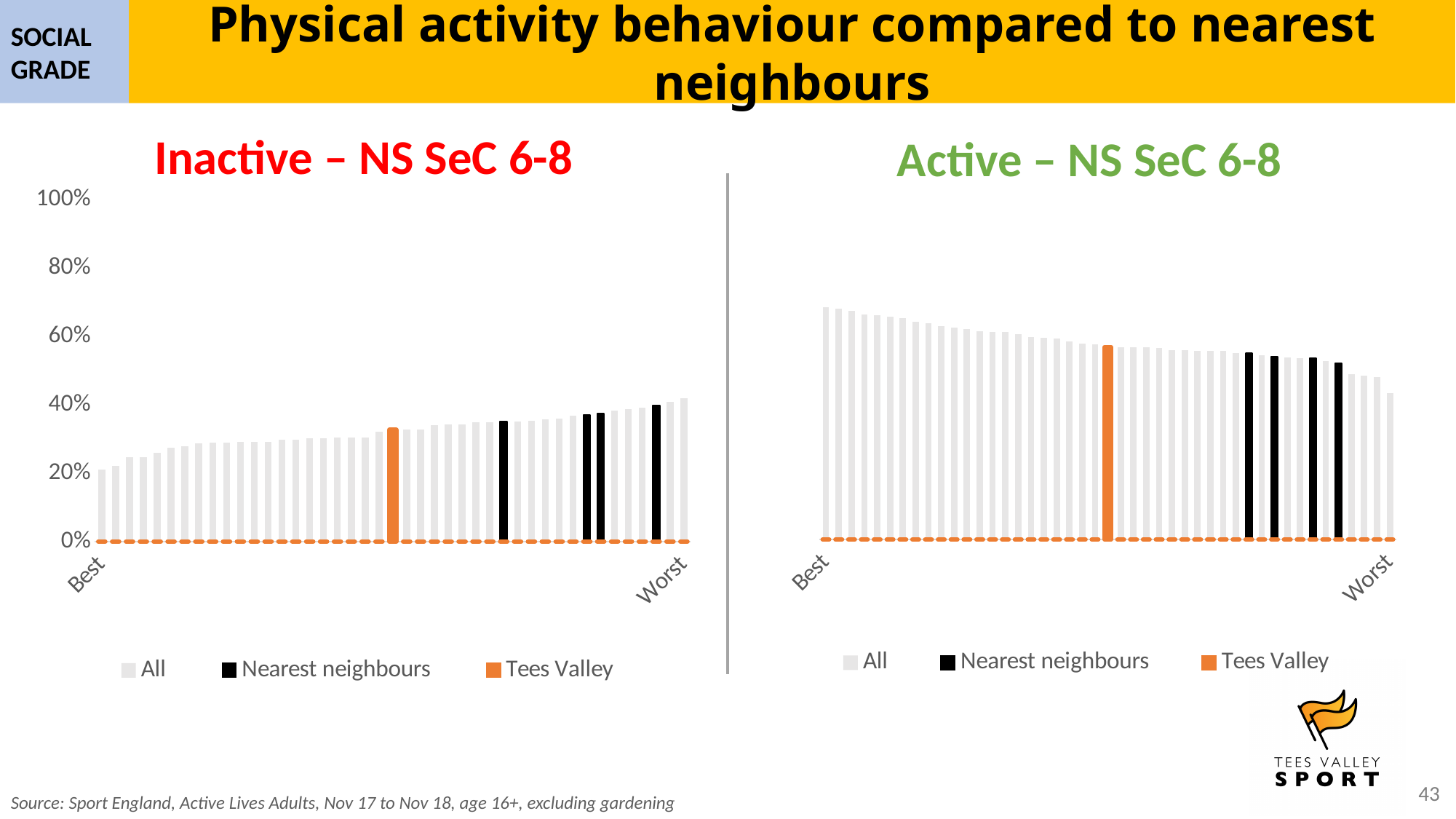
In the 'Active – NS SeC 6-8' chart, is the value for Tees Valley greater or less than 40%? greater In the 'Active – NS SeC 6-8' chart, which colour represents Tees Valley? orange How many series does the legend of the 'Active – NS SeC 6-8' chart list? 3 In the 'Inactive – NS SeC 6-8' chart, is the value for Tees Valley greater or less than 20%? greater Is the Tees Valley value higher in the 'Active – NS SeC 6-8' chart or in the 'Inactive – NS SeC 6-8' chart? Active – NS SeC 6-8 In the 'Active – NS SeC 6-8' chart, is the value for Tees Valley greater or less than 80%? less What type of chart is the 'Inactive – NS SeC 6-8' chart? bar chart In the 'Inactive – NS SeC 6-8' chart, do the bars rise or fall from Best to Worst along the x axis? rise What are the three legend entries of the 'Inactive – NS SeC 6-8' chart? All, Nearest neighbours, Tees Valley How many 'Nearest neighbours' bars are shown in the 'Inactive – NS SeC 6-8' chart? 4 In the 'Active – NS SeC 6-8' chart, do the bars rise or fall from Best to Worst along the x axis? fall